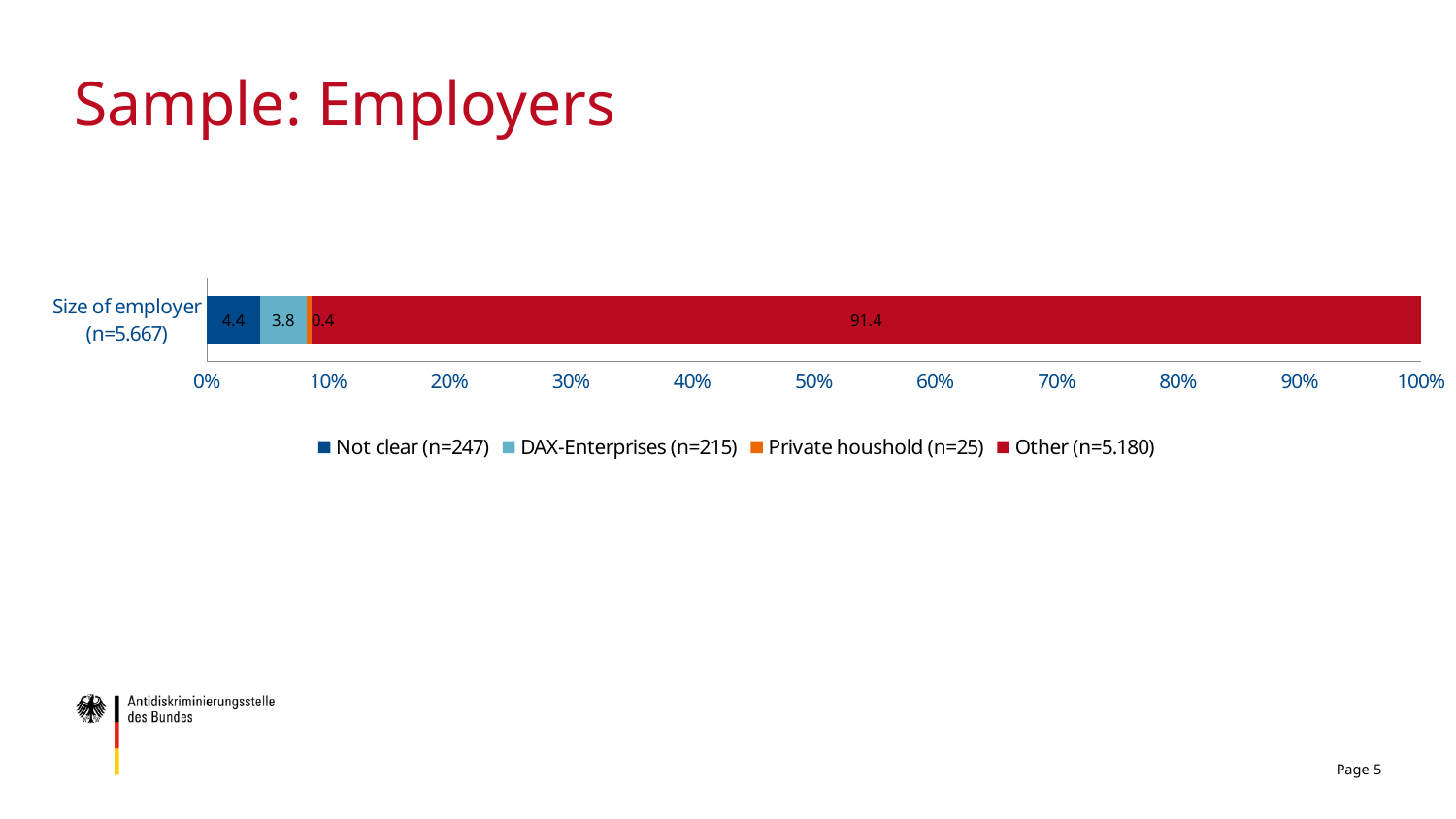
What value is shown for the Other (n=5.180) segment? 91.4 Which is larger, the Not clear (n=247) segment or the DAX-Enterprises (n=215) segment? Not clear (n=247) What value is shown for the Private houshold (n=25) segment? 0.4 Which series has the largest segment in the Size of employer bar? Other (n=5.180) Which series has the smallest segment in the Size of employer bar? Private houshold (n=25) What value is shown for the Not clear (n=247) segment of the Size of employer bar? 4.4 How many series does the legend list? 4 What is the difference between the Not clear (n=247) value and the DAX-Enterprises (n=215) value? 0.6 Is the value for Other (n=5.180) greater or less than 90%? greater What is the total of the four segments in the Size of employer bar? 100 What kind of chart is shown on the slide? Stacked bar chart What value is shown for the DAX-Enterprises (n=215) segment? 3.8